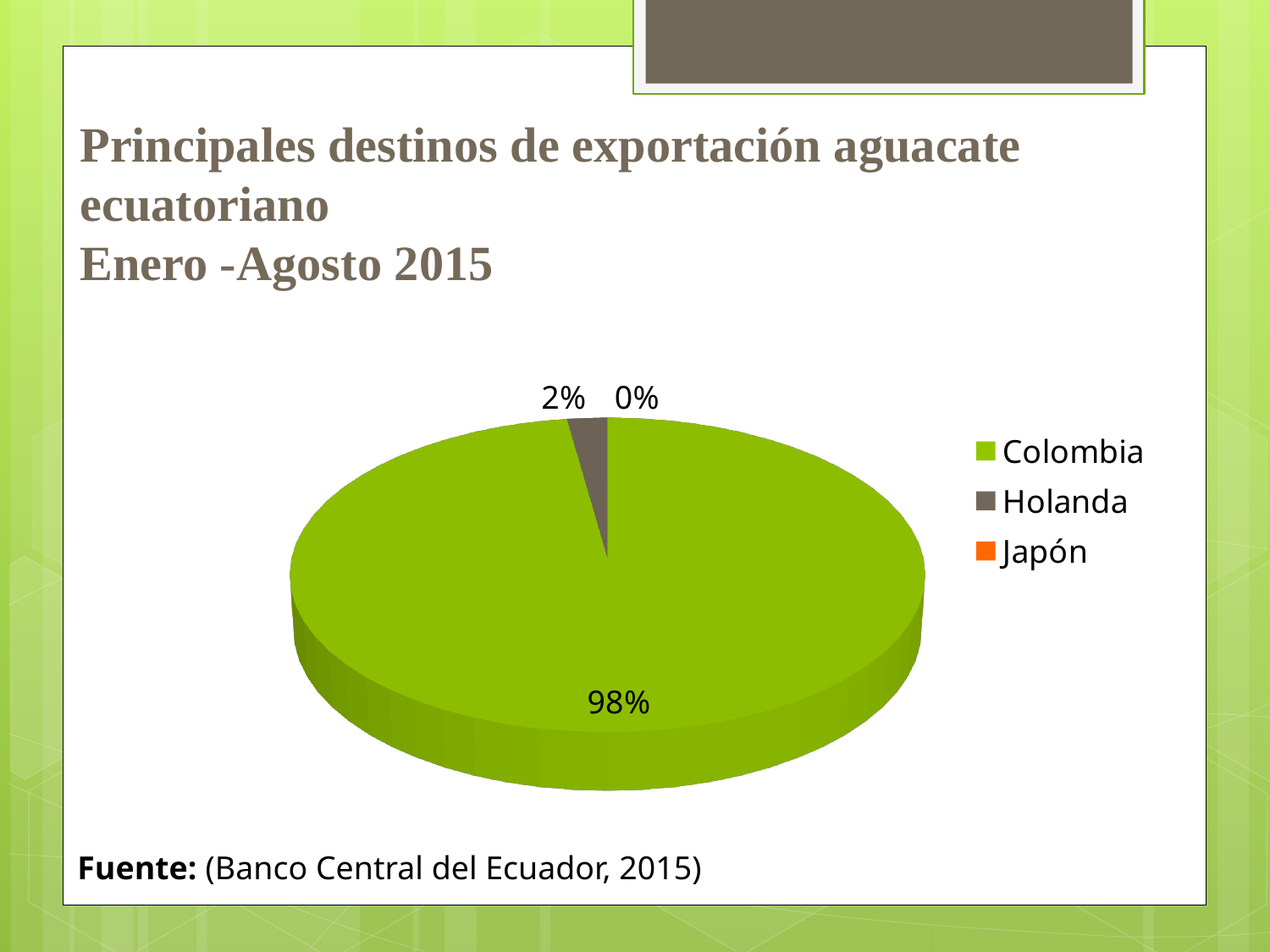
What share of the pie does Japón hold? 0% What kind of chart is shown on the slide? Pie chart What source is cited below the chart? Banco Central del Ecuador, 2015 Which destination has the smallest share of the pie? Japón How many destinations are listed in the legend? 3 What colour is the slice for Colombia? Green What is the difference in percentage points between Colombia's share and Holanda's share? 96 What share of the pie does Holanda hold? 2% Which has a larger share, Colombia or Holanda? Colombia What share of the pie does Colombia hold? 98% Which destination has the largest share of the pie? Colombia Which has a larger share, Holanda or Japón? Holanda